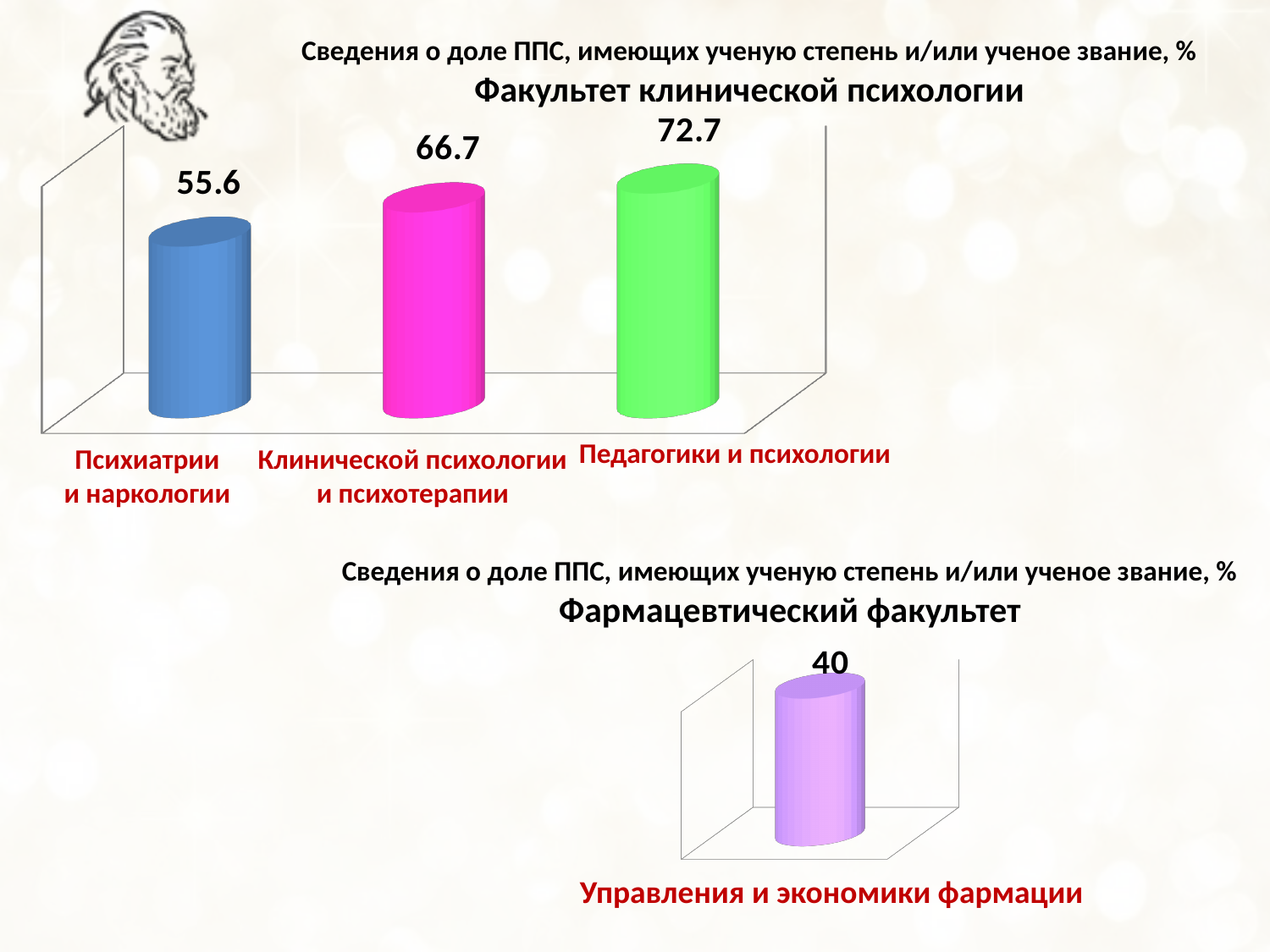
In the chart titled 'Факультет клинической психологии', what is the value for 'Педагогики и психологии'? 72.7 How many categories are shown in the chart titled 'Фармацевтический факультет'? 1 In the chart titled 'Факультет клинической психологии', which category has the lowest value? Психиатрии и наркологии In the chart titled 'Факультет клинической психологии', what is the difference between the values for 'Педагогики и психологии' and 'Клинической психологии и психотерапии'? 6 In the chart titled 'Факультет клинической психологии', what is the value for 'Клинической психологии и психотерапии'? 66.7 In the chart titled 'Факультет клинической психологии', which is larger: the value for 'Клинической психологии и психотерапии' or the value for 'Психиатрии и наркологии'? Клинической психологии и психотерапии In the chart titled 'Факультет клинической психологии', what is the value for 'Психиатрии и наркологии'? 55.6 How many categories are shown in the chart titled 'Факультет клинической психологии'? 3 In the chart titled 'Фармацевтический факультет', what is the value for 'Управления и экономики фармации'? 40 In the chart titled 'Факультет клинической психологии', what is the difference between the values for 'Педагогики и психологии' and 'Психиатрии и наркологии'? 17.1 In the chart titled 'Факультет клинической психологии', which category has the highest value? Педагогики и психологии What kind of chart is the chart titled 'Факультет клинической психологии'? Bar chart